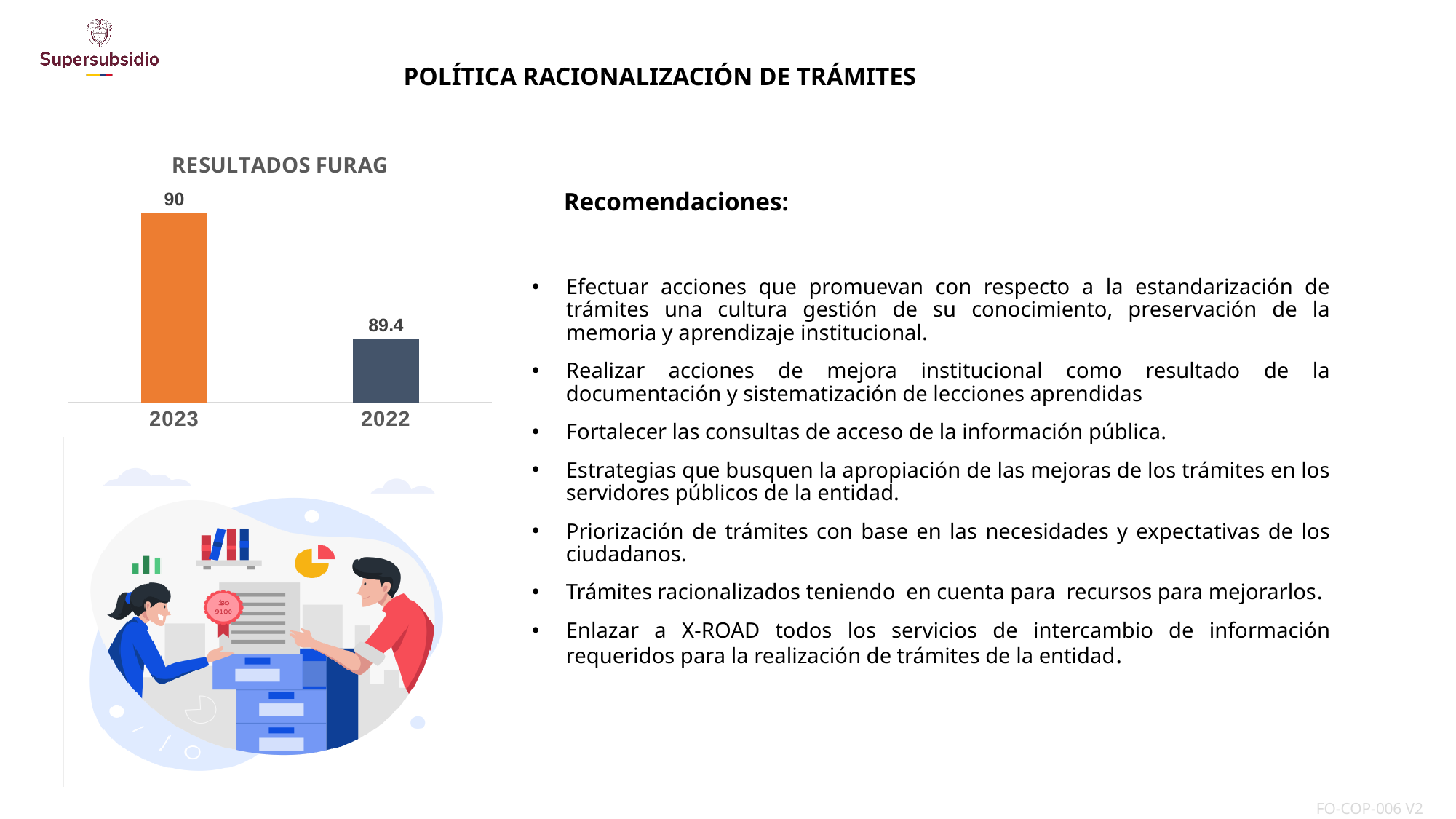
Reading the RESULTADOS FURAG chart from left to right (2023 to 2022), do the values rise or fall? fall What type of chart is RESULTADOS FURAG? bar chart What is the value for 2023 in the RESULTADOS FURAG chart? 90 How many bars are shown in the RESULTADOS FURAG chart? 2 Which year has the lowest value in the RESULTADOS FURAG chart? 2022 In the RESULTADOS FURAG chart, is the value for 2023 larger or smaller than the value for 2022? larger What colour is the bar for 2023 in the RESULTADOS FURAG chart? orange What is the value for 2022 in the RESULTADOS FURAG chart? 89.4 Which year has the highest value in the RESULTADOS FURAG chart? 2023 What is the difference between the 2023 and 2022 values in the RESULTADOS FURAG chart? 0.6 What is the title of the chart on the slide? RESULTADOS FURAG